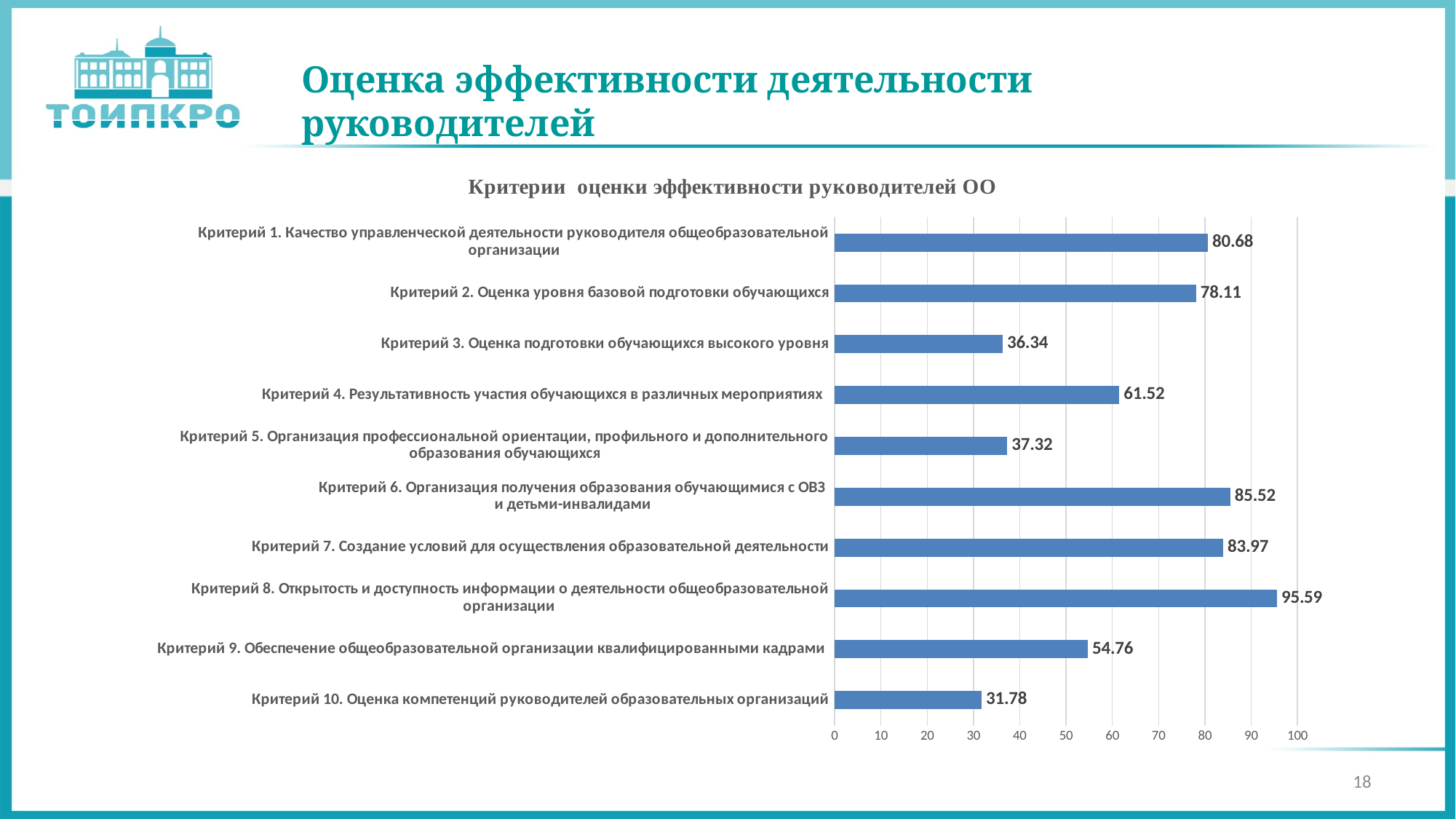
Which criterion has the highest value? Критерий 8. Открытость и доступность информации о деятельности общеобразовательной организации What is the difference between the values for Критерий 1 and Критерий 2? 2.57 How many criteria are shown in the chart? 10 What is the value for Критерий 6 (Организация получения образования обучающимися с ОВЗ и детьми-инвалидами)? 85.52 What is the difference between the values for Критерий 8 and Критерий 10? 63.81 What is the value for Критерий 9 (Обеспечение общеобразовательной организации квалифицированными кадрами)? 54.76 What is the title of the chart? Критерии оценки эффективности руководителей ОО What type of chart is shown on the slide? bar chart What is the value for Критерий 1 (Качество управленческой деятельности руководителя общеобразовательной организации)? 80.68 Which criterion has the lowest value? Критерий 10. Оценка компетенций руководителей образовательных организаций Which has a larger value, Критерий 4 or Критерий 9? Критерий 4 Is the value for Критерий 3 greater or less than 40? less